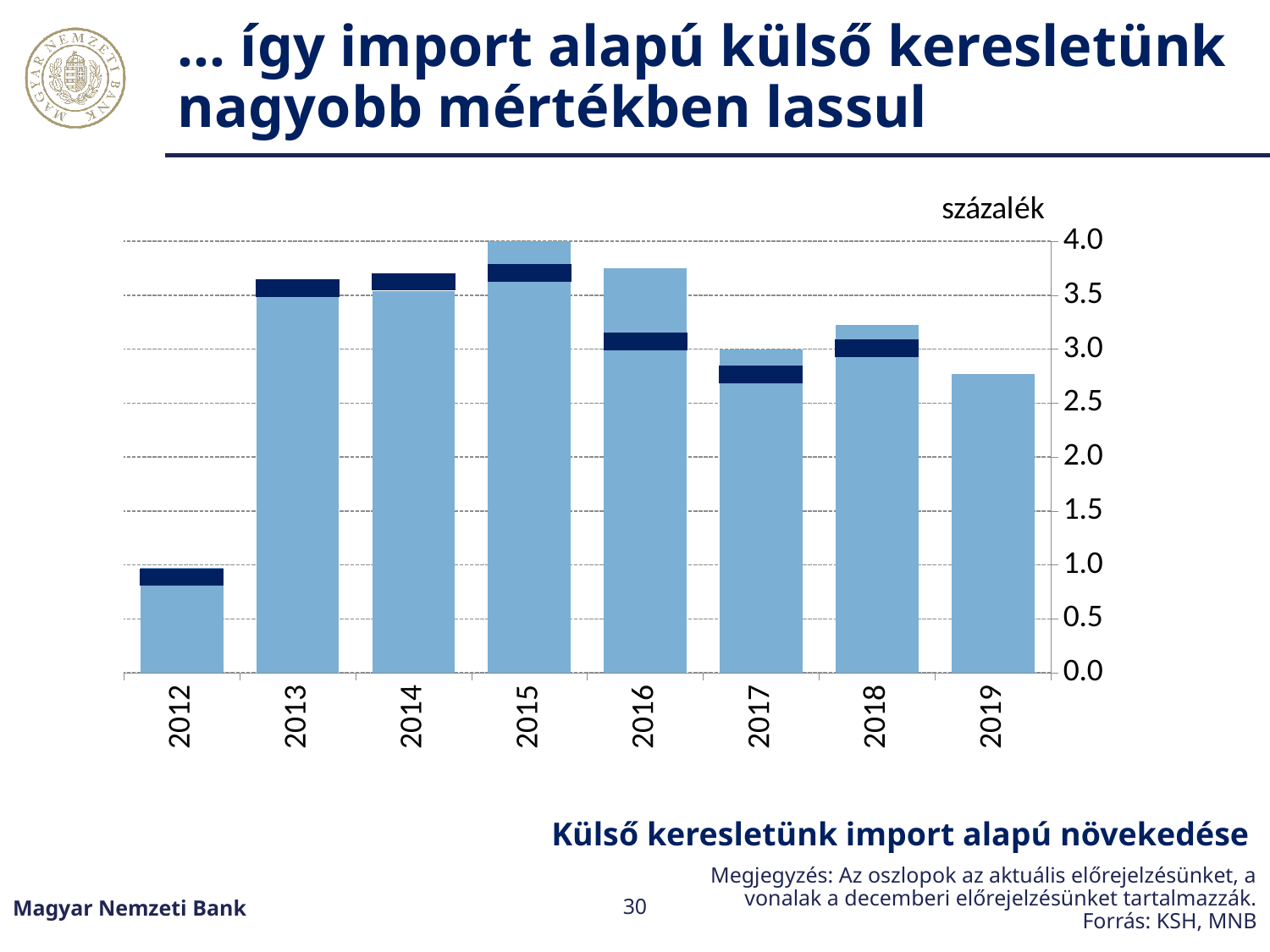
From 2015 to 2017, do the bar values rise or fall? fall What kind of chart is shown on the slide? bar chart What unit label is shown above the y axis of the chart? százalék Is the value for 2017 greater or less than 2.5? greater Is the value for 2013 greater or less than 3.0? greater Is the value for 2019 greater or less than 3.0? less How many years are shown on the x axis of the chart? 8 Which year has the larger value, 2016 or 2017? 2016 Which year has the highest bar in the chart? 2015 Which year has the larger value, 2013 or 2019? 2013 Which year has the lowest bar in the chart? 2012